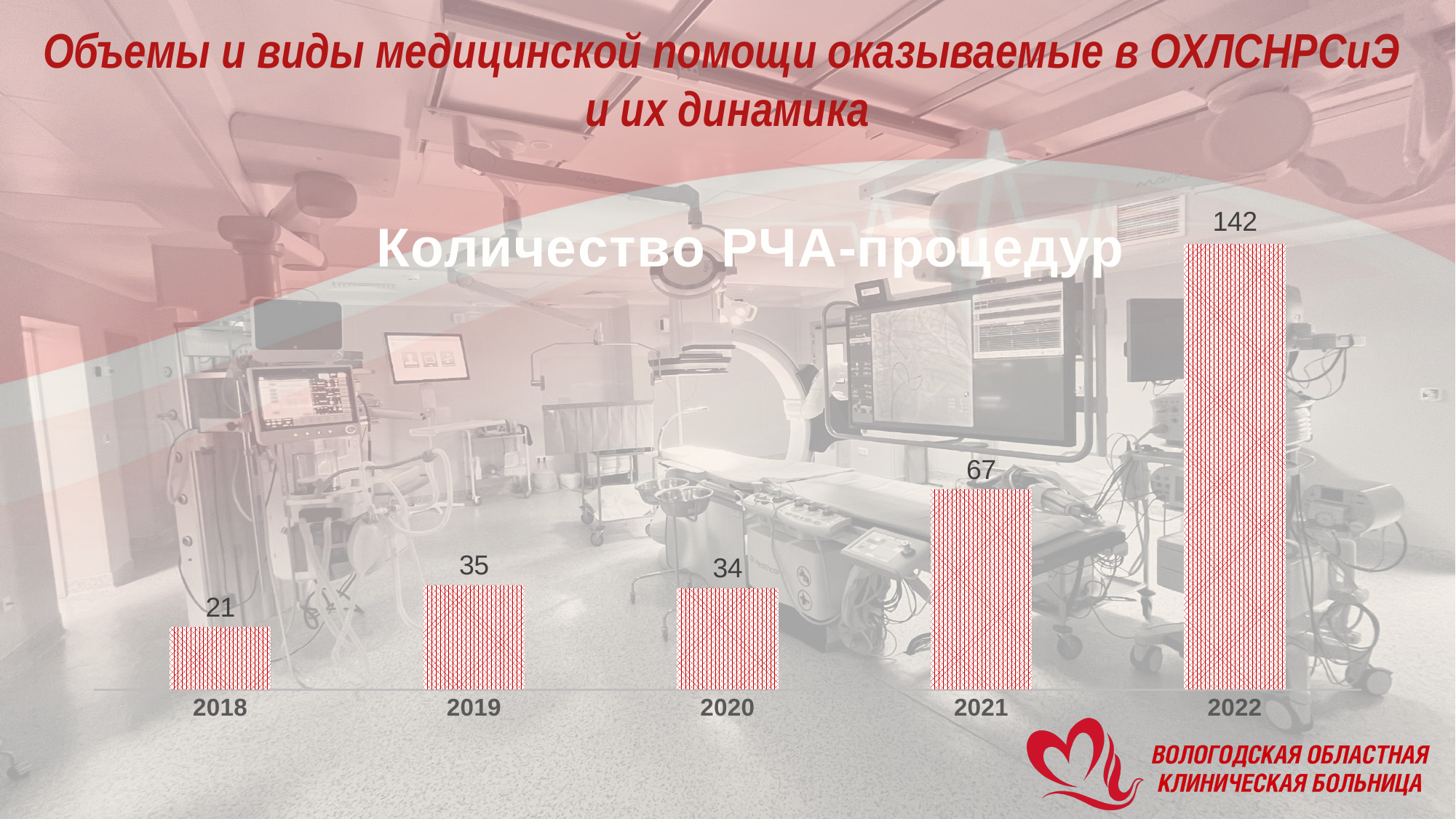
Do the values generally rise or fall from 2018 to 2022? Rise Which is larger, the value for 2019 or the value for 2020? 2019 Which year has the highest number of RFA procedures? 2022 Which year has the lowest number of RFA procedures? 2018 What is the number of RFA procedures (Количество РЧА-процедур) in 2018? 21 What is the difference between the values for 2022 and 2021? 75 How many years are shown on the x axis of the chart? 5 What kind of chart is shown on the slide? Bar chart What is the difference between the values for 2019 and 2018? 14 What is the title of the chart? Количество РЧА-процедур What is the value shown for 2021? 67 What is the value shown for 2022? 142